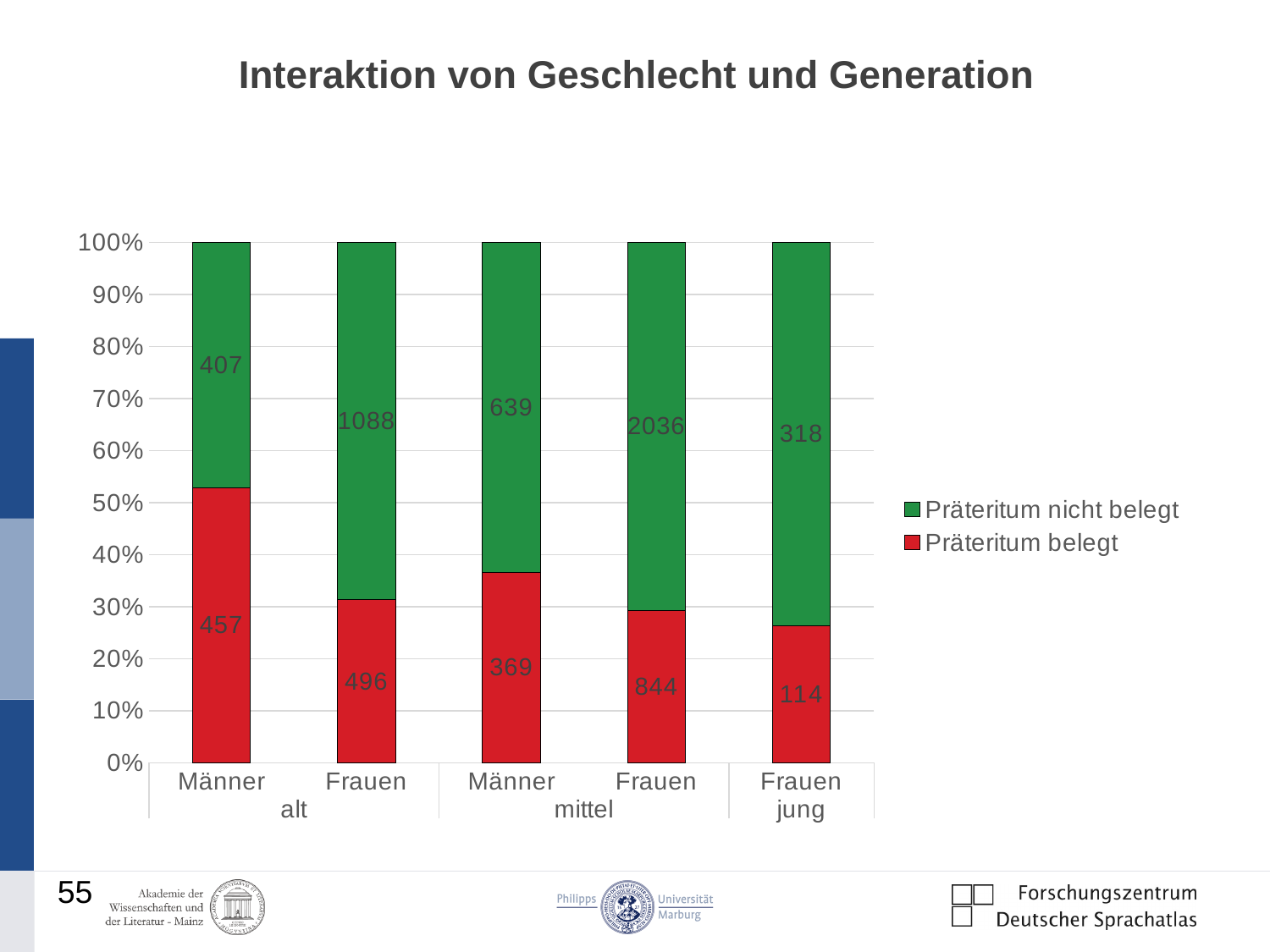
What is the title of the chart? Interaktion von Geschlecht und Generation Which is larger: the 'Präteritum belegt' value for Männer mittel or for Frauen alt? Frauen alt What type of chart is shown on the slide? stacked bar chart What is the 'Präteritum belegt' value for Frauen in the 'jung' group? 114 How many bars (categories) are plotted in the chart? 5 Which category has the highest 'Präteritum nicht belegt' value? Frauen mittel What is the total count (belegt plus nicht belegt) for Männer in the 'mittel' group? 1008 What is the 'Präteritum belegt' value for Männer in the 'alt' group? 457 How many series does the legend list? 2 Which category has the lowest 'Präteritum belegt' value? Frauen jung What is the 'Präteritum nicht belegt' value for Frauen in the 'mittel' group? 2036 What is the difference between the 'Präteritum nicht belegt' values for Frauen alt and Männer alt? 681